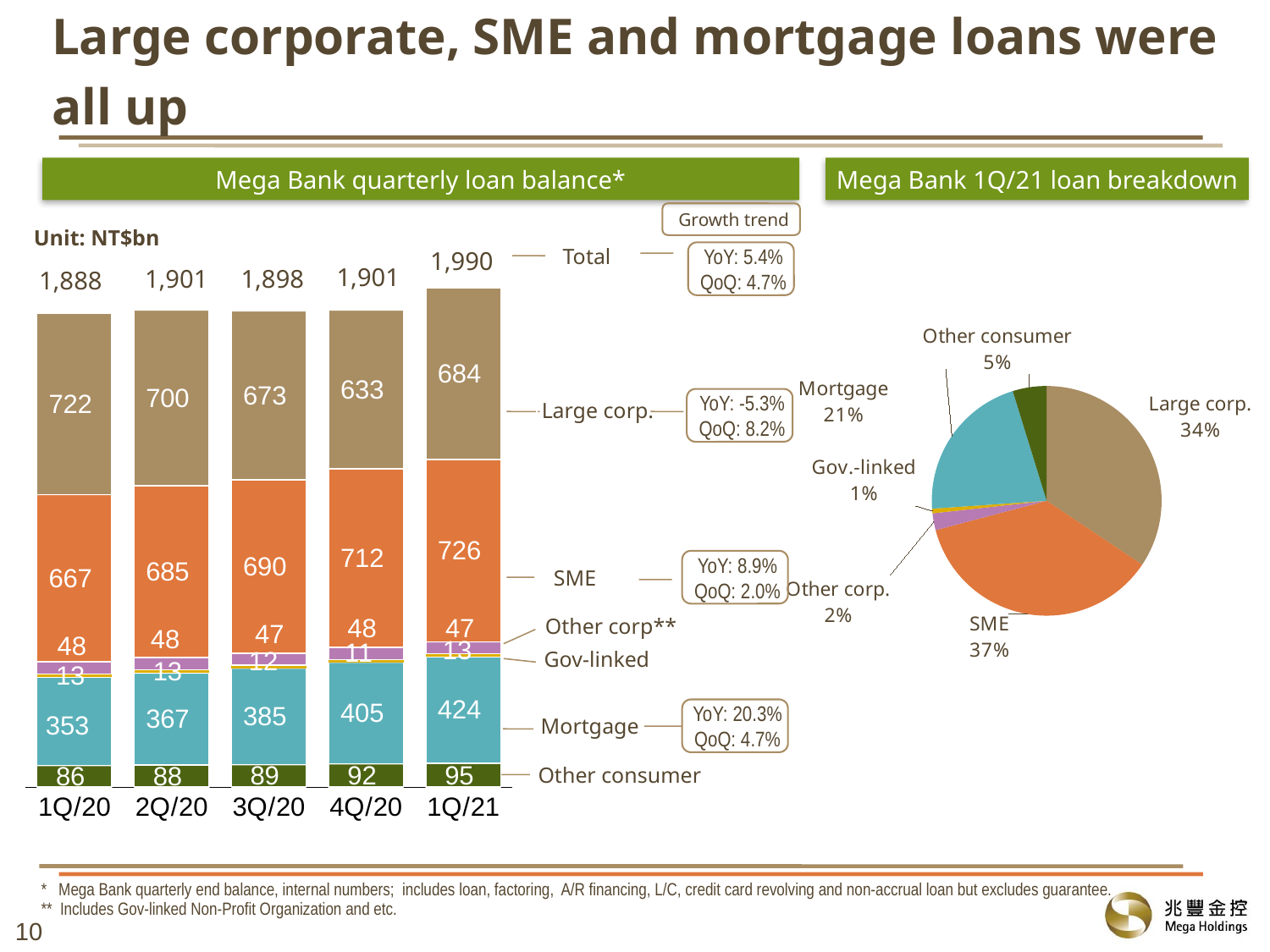
How many quarters are shown in the Mega Bank quarterly loan balance chart? 5 In the Mega Bank quarterly loan balance chart, does the Mortgage balance rise or fall from 1Q/20 to 1Q/21? Rise In the Mega Bank quarterly loan balance chart, which quarter has the highest total loan balance? 1Q/21 In the Mega Bank quarterly loan balance chart, what is the total loan balance for 1Q/21? 1,990 In the Mega Bank 1Q/21 loan breakdown pie chart, what share does SME account for? 37% In the Mega Bank 1Q/21 loan breakdown pie chart, which category has the smallest share? Gov.-linked In the Mega Bank quarterly loan balance chart, what is the Large corp. balance in 4Q/20? 633 In the Mega Bank quarterly loan balance chart, in which quarter is the Large corp. balance lowest? 4Q/20 What kind of chart is the Mega Bank quarterly loan balance chart? Stacked bar chart In the Mega Bank quarterly loan balance chart, by how much did the SME balance increase from 1Q/20 to 1Q/21? 59 In the Mega Bank quarterly loan balance chart, which is larger in 1Q/21, the Large corp. balance or the SME balance? SME In the Mega Bank quarterly loan balance chart, what is the Mortgage balance in 1Q/21? 424